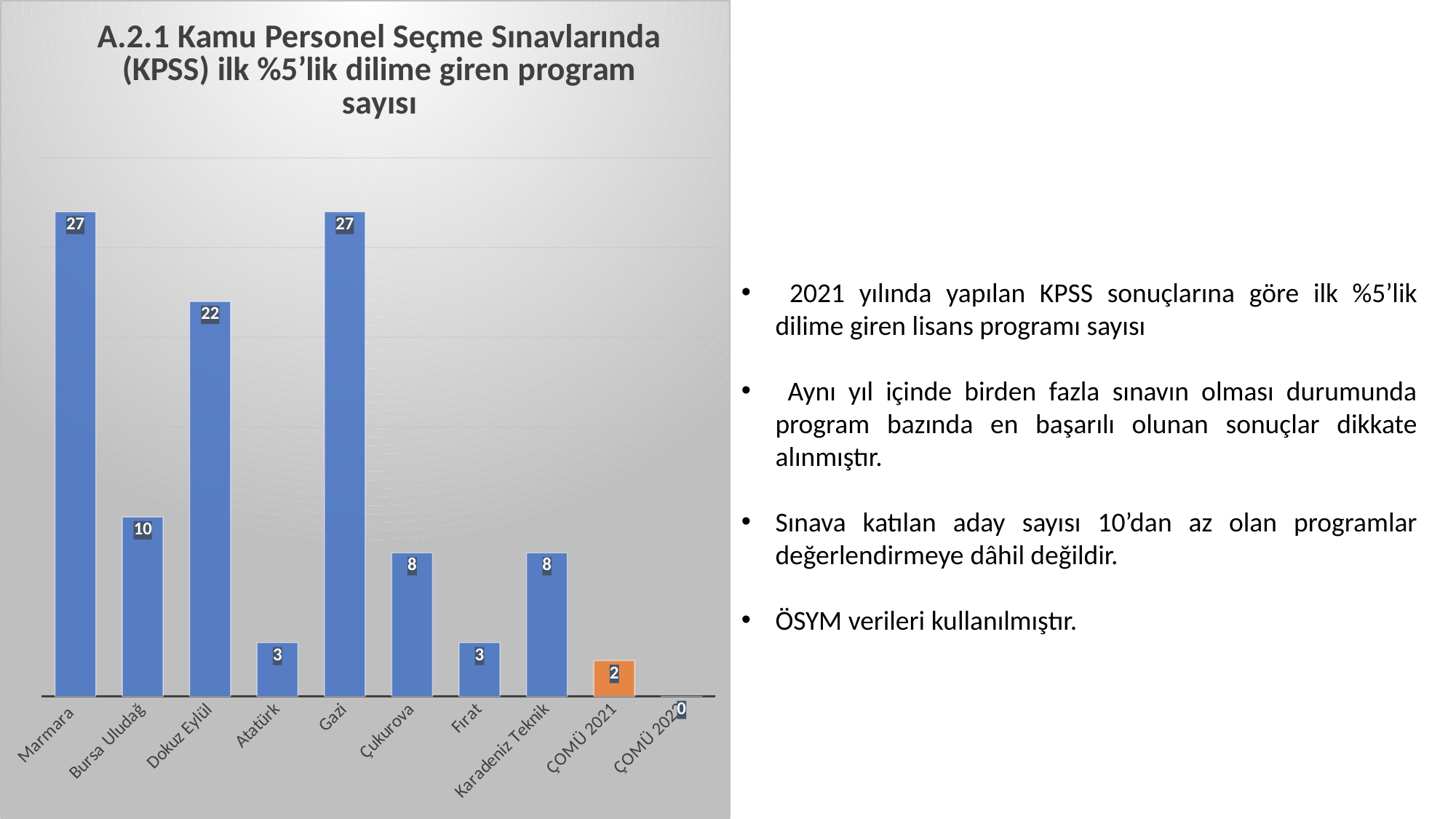
How many categories are shown on the x axis? 10 What is the difference between the values for Marmara and Bursa Uludağ? 17 What is the difference between the values for Dokuz Eylül and Çukurova? 14 Which has a larger value, Dokuz Eylül or Gazi? Gazi What kind of chart is shown on the slide? Bar chart What is the value for ÇOMÜ 2021? 2 What is the value for Marmara? 27 Which category's bar is coloured orange instead of blue? ÇOMÜ 2021 What is the value for Dokuz Eylül? 22 Which has a larger value, Çukurova or Atatürk? Çukurova What is the value for Karadeniz Teknik? 8 What is the value for Bursa Uludağ? 10